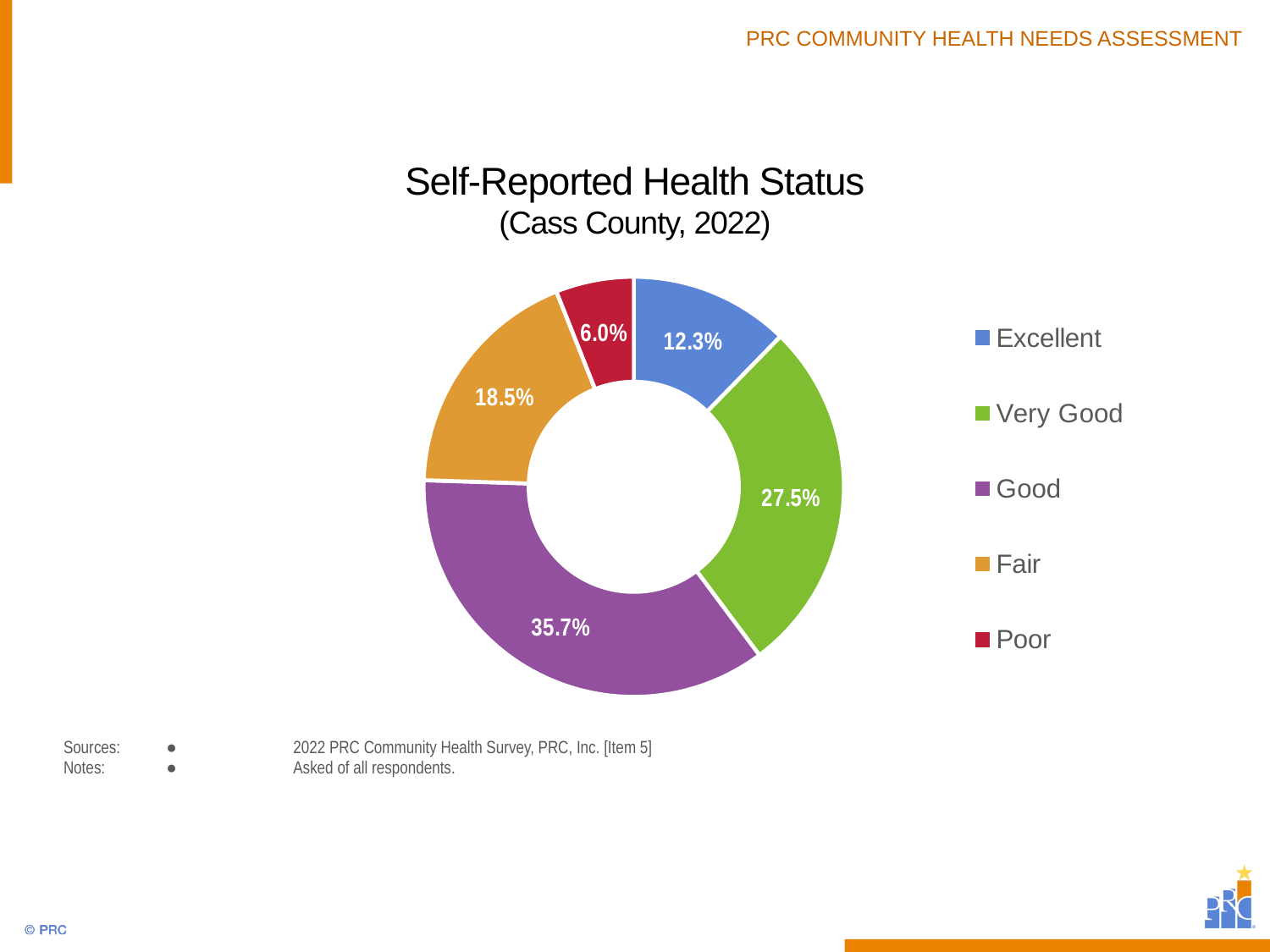
Which is larger, the share for Fair or the share for Excellent? Fair What kind of chart is shown on the slide? Pie chart (doughnut) How many categories are shown in the chart? 5 What colour represents the Very Good category in the chart? Green What is the difference in percentage points between the Good and Very Good shares? 8.2 What percentage of respondents reported their health status as Poor? 6.0% Which health status category has the largest share? Good What percentage of respondents reported their health status as Good? 35.7% What percentage of respondents reported their health status as Excellent? 12.3% What is the combined share of respondents reporting Excellent or Very Good health? 39.8% What percentage of respondents reported their health status as Fair? 18.5% Which health status category has the smallest share? Poor